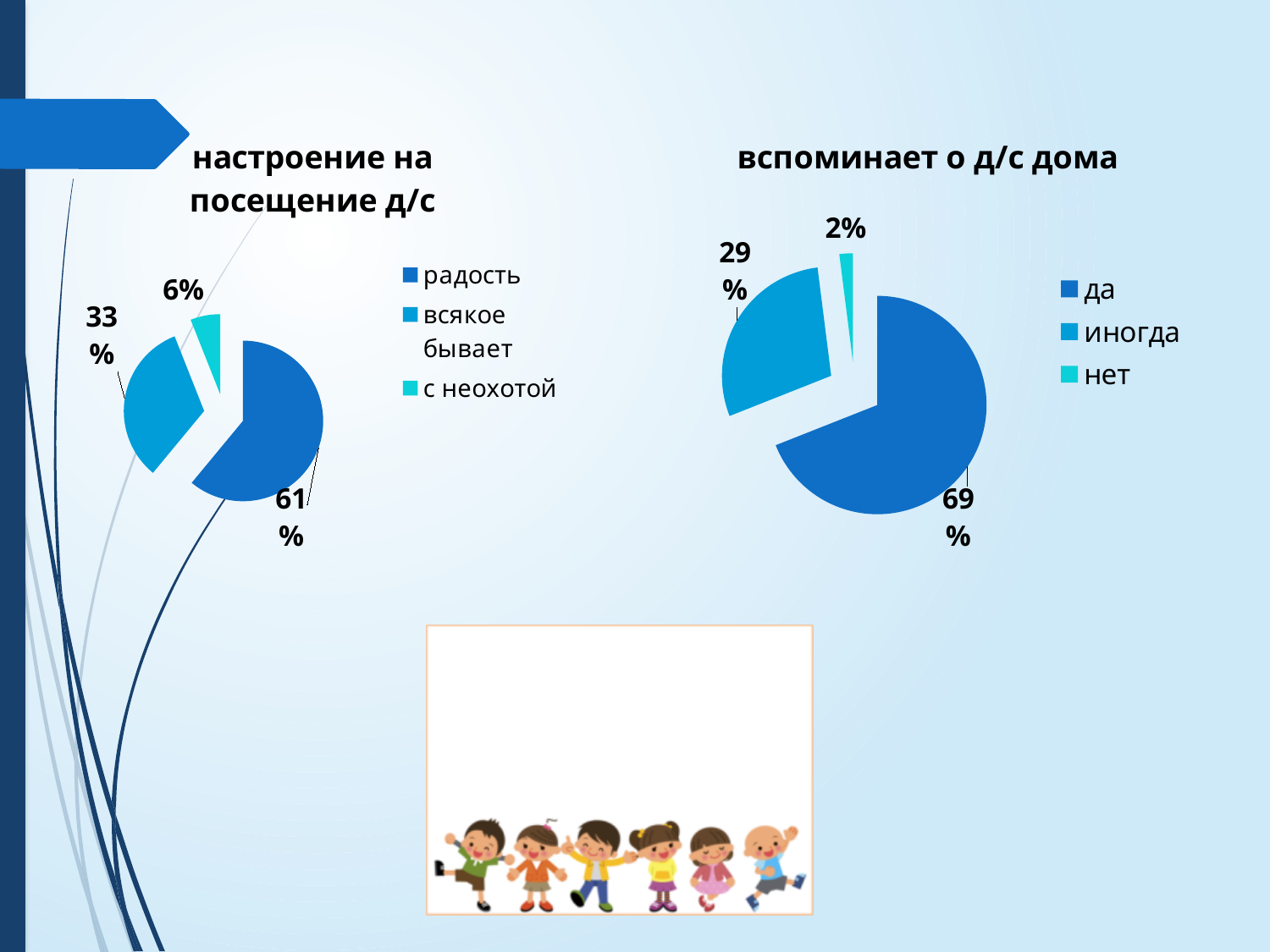
In the chart titled "настроение на посещение д/с", what percentage is shown for "радость"? 61% What type of chart is the chart titled "вспоминает о д/с дома"? pie chart In the chart titled "настроение на посещение д/с", which category has the largest share? радость In the chart titled "вспоминает о д/с дома", what percentage is shown for "нет"? 2% In the chart titled "вспоминает о д/с дома", which is larger: the share for "да" or the share for "иногда"? да In the chart titled "настроение на посещение д/с", what is the difference between the shares for "радость" and "всякое бывает"? 28% In the chart titled "вспоминает о д/с дома", what is the difference between the shares for "да" and "иногда"? 40% In the chart titled "вспоминает о д/с дома", what percentage is shown for "иногда"? 29% How many slices does the chart titled "настроение на посещение д/с" have? 3 How many entries does the legend of the chart titled "вспоминает о д/с дома" list? 3 In the chart titled "настроение на посещение д/с", what percentage is shown for "с неохотой"? 6% In the chart titled "вспоминает о д/с дома", which category has the smallest share? нет